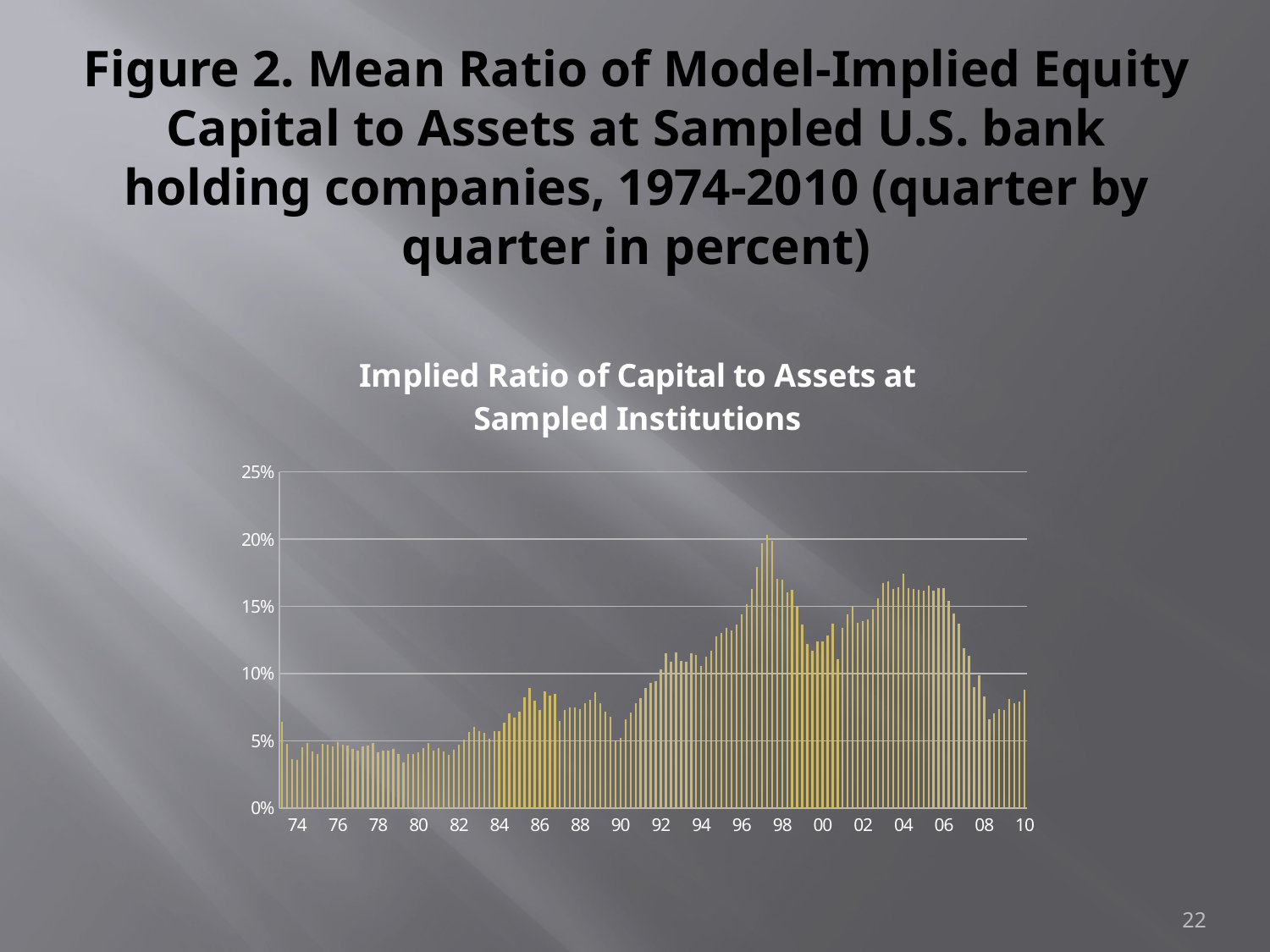
Does the implied ratio generally rise or fall between 2006 and 2008? fall What kind of chart is shown on the slide? bar chart Is the peak value of the implied ratio around 1997-98 greater or less than 15%? greater What is the title of the chart on the slide? Implied Ratio of Capital to Assets at Sampled Institutions Which is larger, the implied ratio around 2004 or around 1980? around 2004 Does the implied ratio generally rise or fall between 1990 and 1997? rise Is the implied ratio around 2004 greater or less than 15%? greater What is the highest value shown on the chart's vertical axis? 25% How many year labels are shown along the x axis of the chart? 19 Around which year labelled on the x axis does the implied ratio reach its highest level? 98 Is the implied ratio around 1990 greater or less than 10%? less